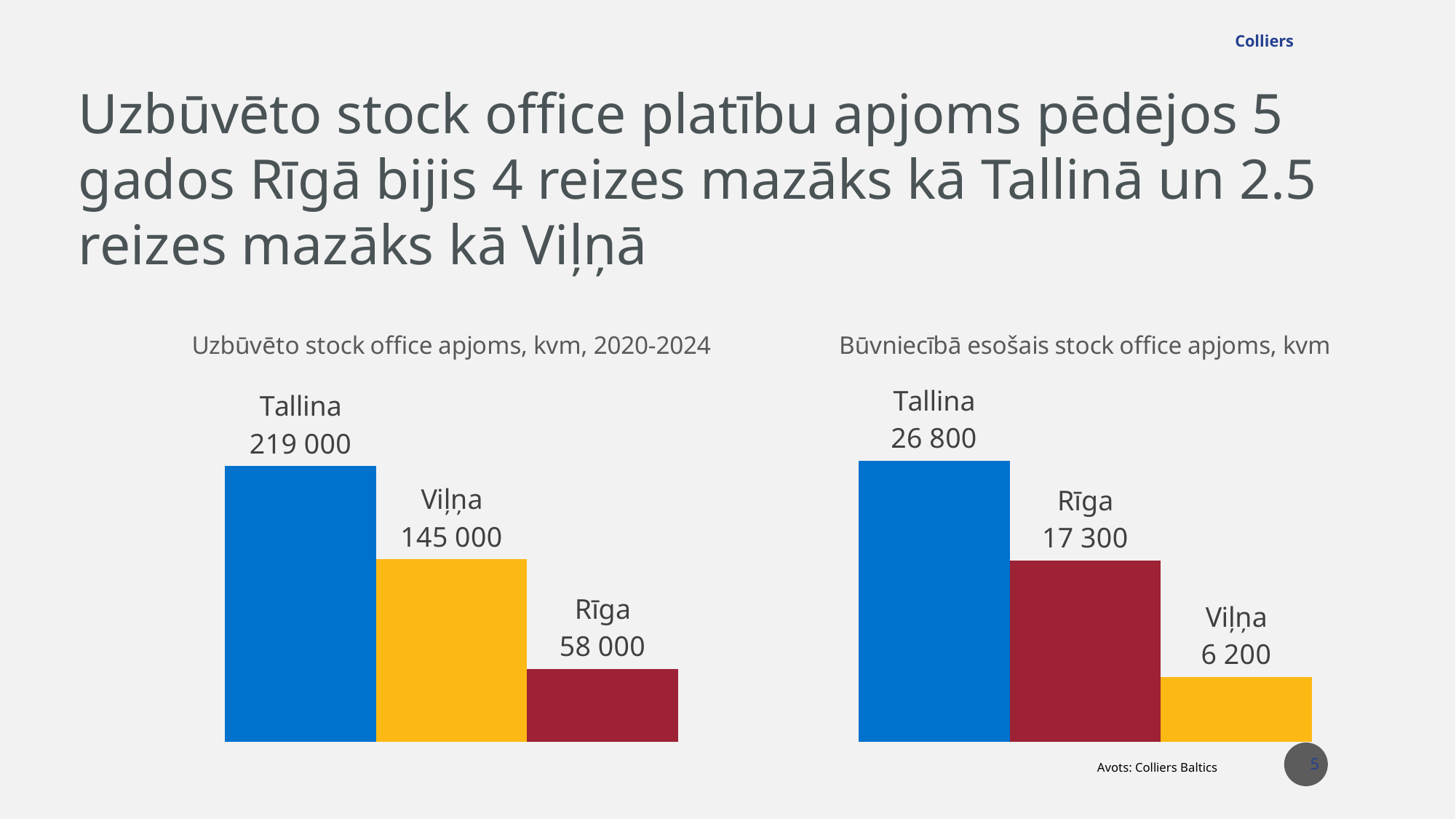
In the chart 'Būvniecībā esošais stock office apjoms, kvm', which city has the lowest value? Viļņa In the chart 'Uzbūvēto stock office apjoms, kvm, 2020-2024', what is the value for Tallina? 219 000 In the chart 'Būvniecībā esošais stock office apjoms, kvm', what is the value for Rīga? 17 300 In the chart 'Uzbūvēto stock office apjoms, kvm, 2020-2024', what colour is the bar for Viļņa? Yellow In the chart 'Uzbūvēto stock office apjoms, kvm, 2020-2024', what is the difference between the values for Tallina and Viļņa? 74 000 In the chart 'Uzbūvēto stock office apjoms, kvm, 2020-2024', which is larger, the value for Viļņa or the value for Rīga? Viļņa How many cities are shown in the chart 'Būvniecībā esošais stock office apjoms, kvm'? 3 In the chart 'Uzbūvēto stock office apjoms, kvm, 2020-2024', which city has the highest value? Tallina In the chart 'Būvniecībā esošais stock office apjoms, kvm', what is the difference between the values for Tallina and Rīga? 9 500 What kind of chart is the left chart on the slide? Bar chart In the chart 'Uzbūvēto stock office apjoms, kvm, 2020-2024', what is the value for Rīga? 58 000 In the chart 'Būvniecībā esošais stock office apjoms, kvm', what is the value for Viļņa? 6 200